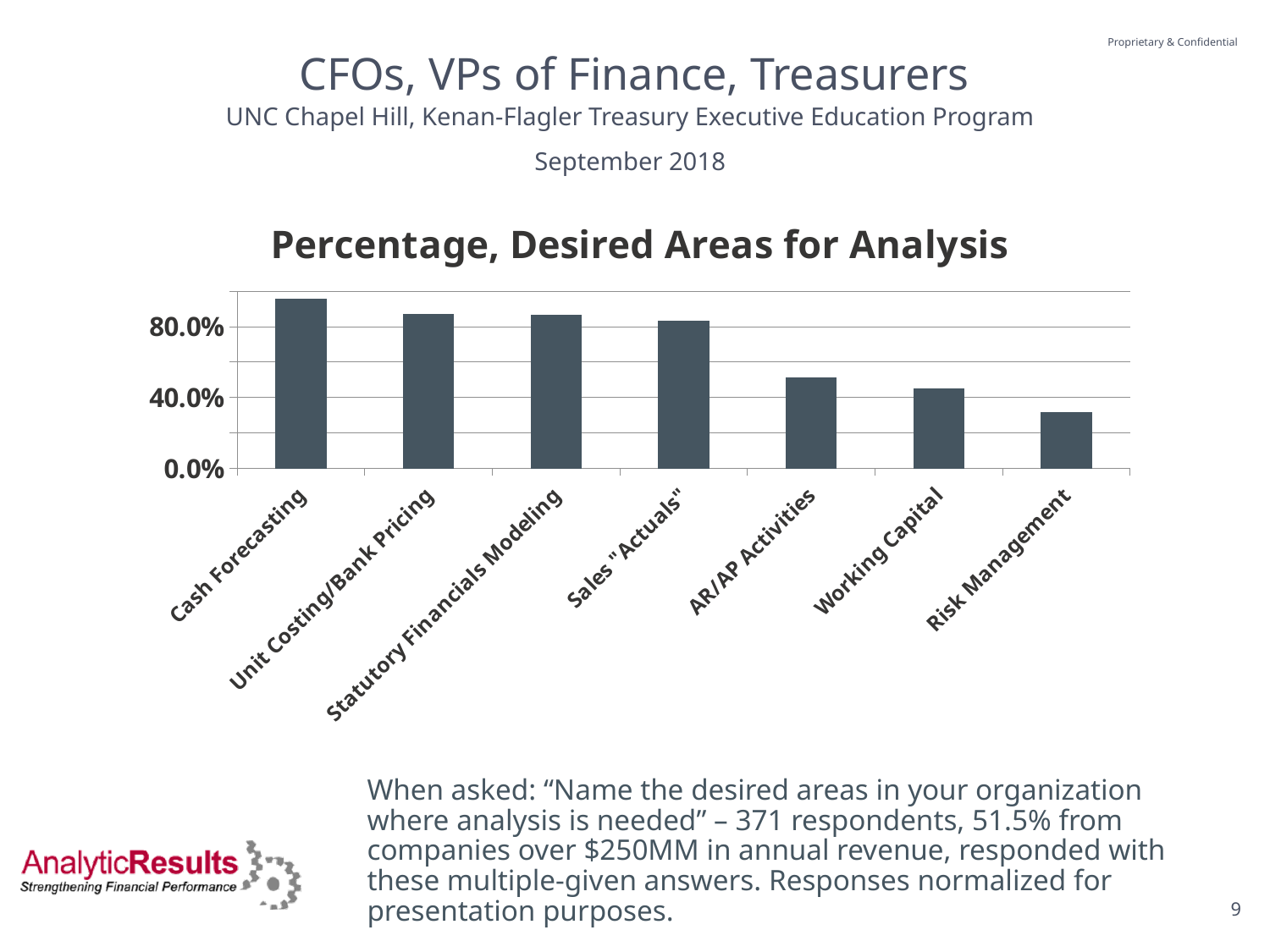
Is the value for AR/AP Activities greater or less than 40.0%? greater Is the value for Working Capital greater or less than 80.0%? less How many categories are plotted in the chart? 7 What is the title of the chart? Percentage, Desired Areas for Analysis Do the values rise or fall moving from left to right along the x axis? fall Which is larger, the value for Working Capital or the value for Risk Management? Working Capital Which category has the highest value in the chart? Cash Forecasting Which is larger, the value for Sales "Actuals" or the value for AR/AP Activities? Sales "Actuals" Is the value for Risk Management greater or less than 40.0%? less Which category has the lowest value in the chart? Risk Management What kind of chart is shown on the slide? bar chart